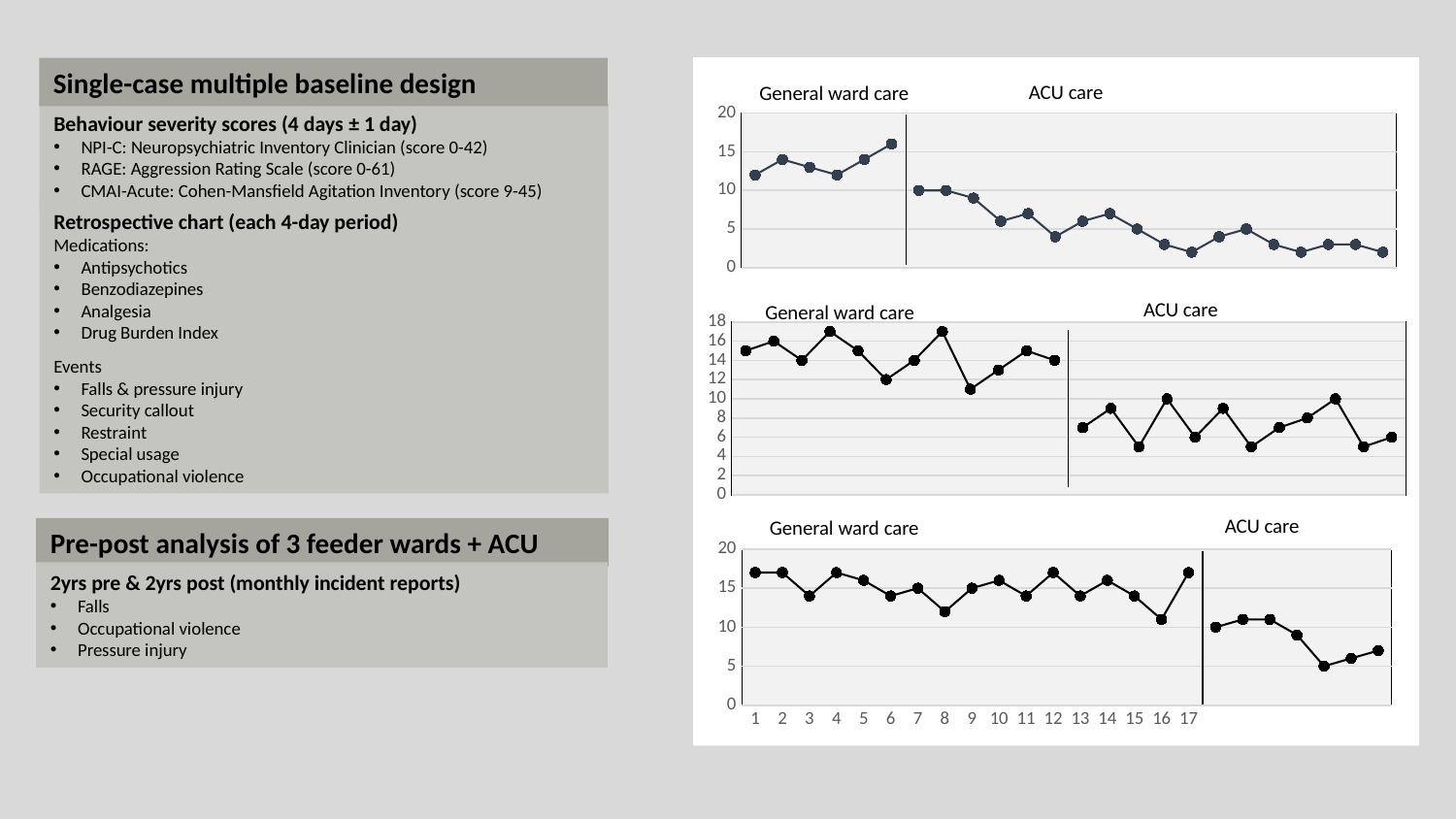
In the middle chart, is the first value in the ACU care section greater or less than 4? greater In the top chart, is the first value in the General ward care section greater or less than 10? greater What kind of chart is the top chart on the slide? line chart In the bottom chart, is the value at x = 1 greater or less than 15? greater In the bottom chart, which is larger, the value at x = 1 or the value at x = 8? x = 1 In the top chart, is the highest point in the General ward care section or the ACU care section? General ward care In the top chart, do the values in the ACU care section generally rise or fall from left to right? fall In the middle chart, which section has the higher values overall, General ward care or ACU care? General ward care What is the highest value shown on the y axis of the middle chart? 18